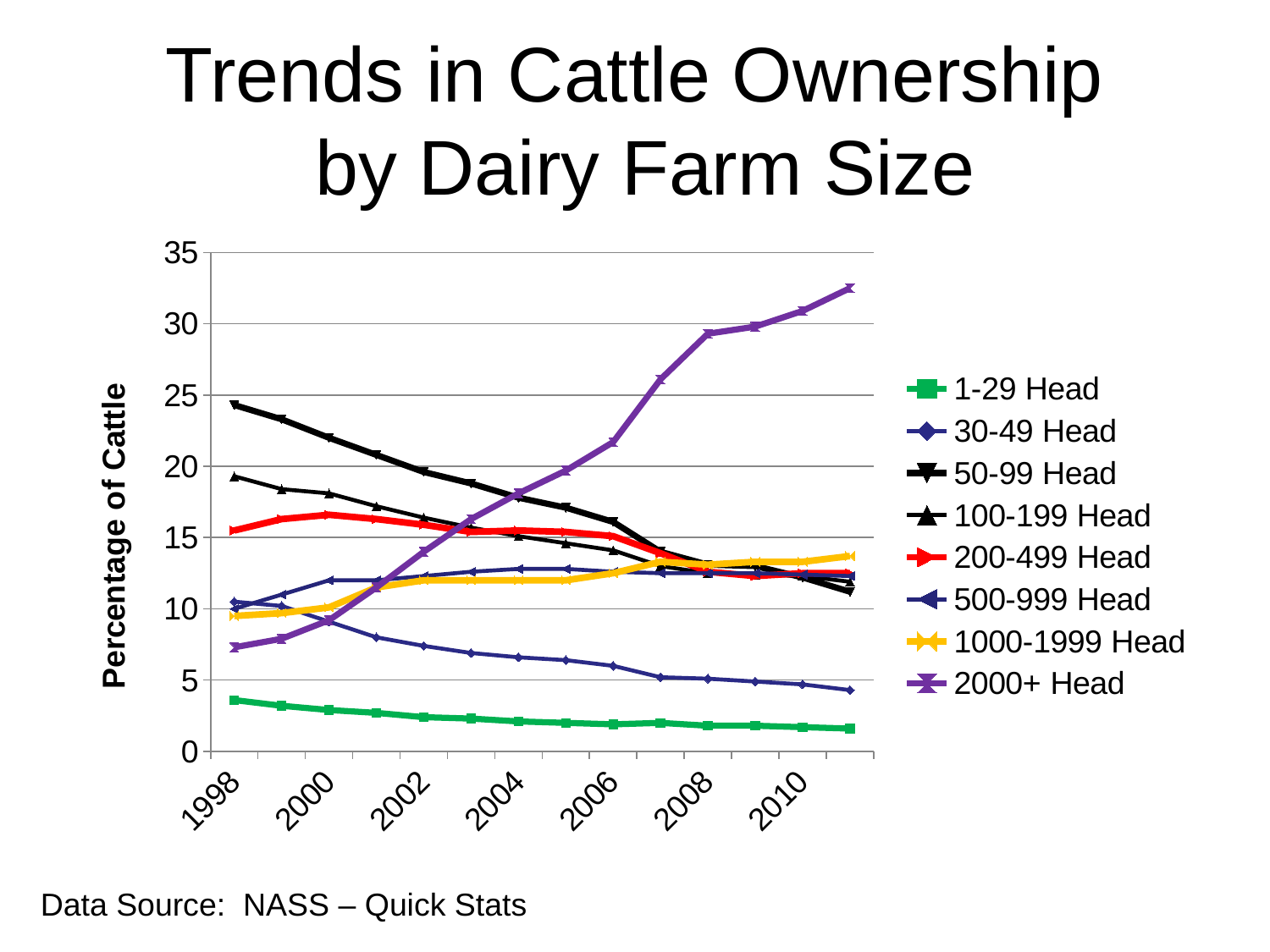
Is the value for 2000+ Head in 2011 greater or less than 30? greater Does the 50-99 Head series rise or fall from 1998 to 2011? fall What is the title of the vertical axis? Percentage of Cattle Which series has the highest value in 1998? 50-99 Head Is the value for 50-99 Head in 1998 greater or less than 20? greater Is the value for 1-29 Head in 1998 greater or less than 5? less In 1998, which is larger: 50-99 Head or 100-199 Head? 50-99 Head How many series does the legend list? 8 What kind of chart is shown on the slide? line chart Which series has the lowest value in 1998? 1-29 Head Which series has the highest value in 2011? 2000+ Head Does the 2000+ Head series rise or fall from 1998 to 2011? rise